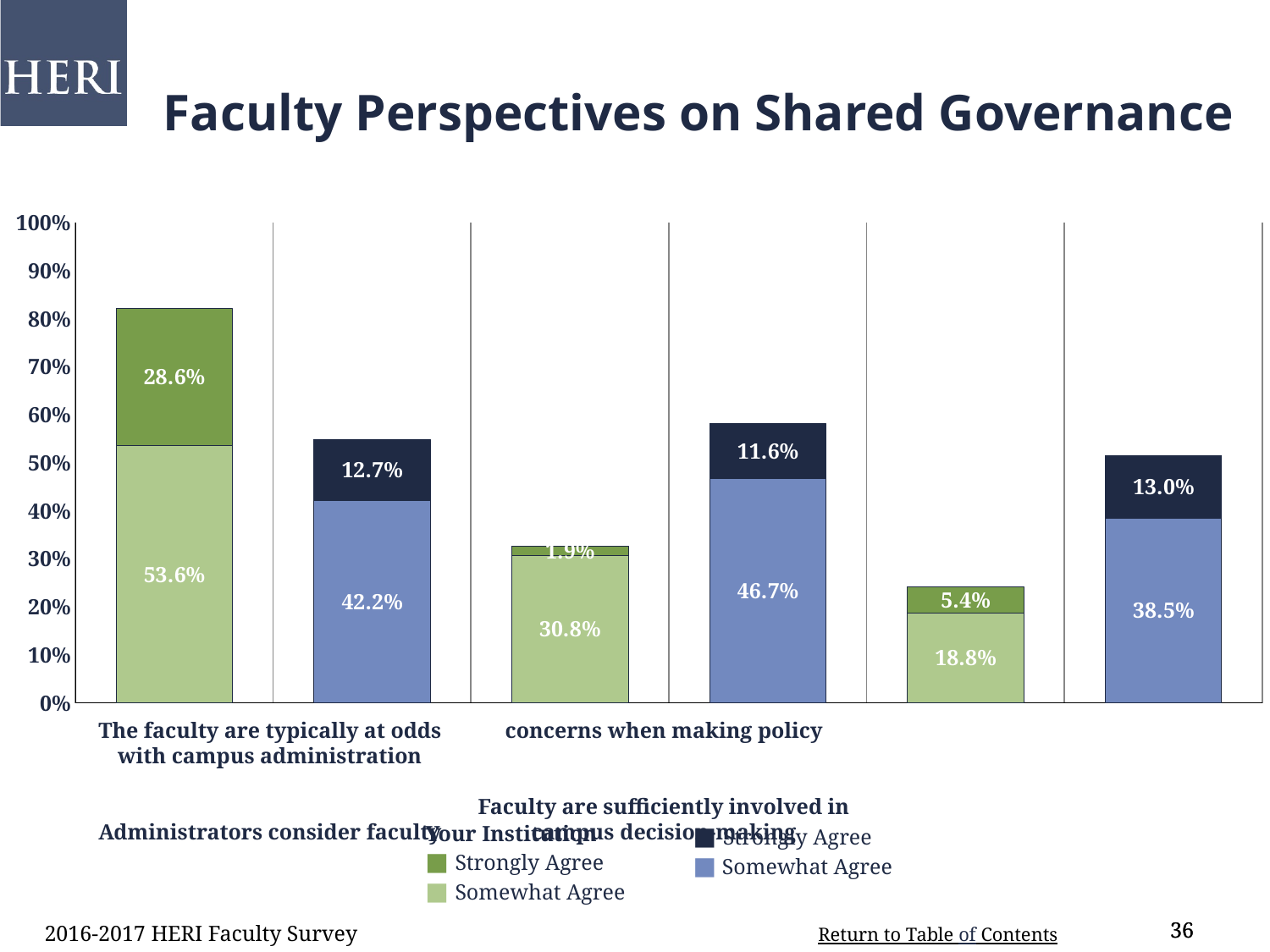
What type of chart is shown on the slide? Stacked bar chart What percentage of faculty at Your Institution somewhat agree that the faculty are typically at odds with campus administration? 53.6% In the blue comparison bar for 'The faculty are typically at odds with campus administration', what is the Strongly Agree value? 12.7% How many statements (categories) are shown along the x axis? 3 What is the Somewhat Agree value in the blue comparison bar for 'Faculty are sufficiently involved in campus decision making'? 38.5% What is the total height of the Your Institution bar for 'Faculty are sufficiently involved in campus decision making'? 24.2% Which statement has the tallest Your Institution (green) bar? The faculty are typically at odds with campus administration What is the difference between the Somewhat Agree values in the blue comparison bar (46.7%) and the Your Institution bar (30.8%) for 'Administrators consider faculty concerns when making policy'? 15.9% What is the total height of the Your Institution bar for 'The faculty are typically at odds with campus administration'? 82.2% What is the Somewhat Agree value for Your Institution on 'Administrators consider faculty concerns when making policy'? 30.8% Which is larger: the Strongly Agree value for Your Institution on 'Faculty are sufficiently involved in campus decision making' (5.4%) or the Strongly Agree value in the blue comparison bar (13.0%)? 13.0% (blue comparison bar) What percentage of faculty at Your Institution strongly agree that the faculty are typically at odds with campus administration? 28.6%